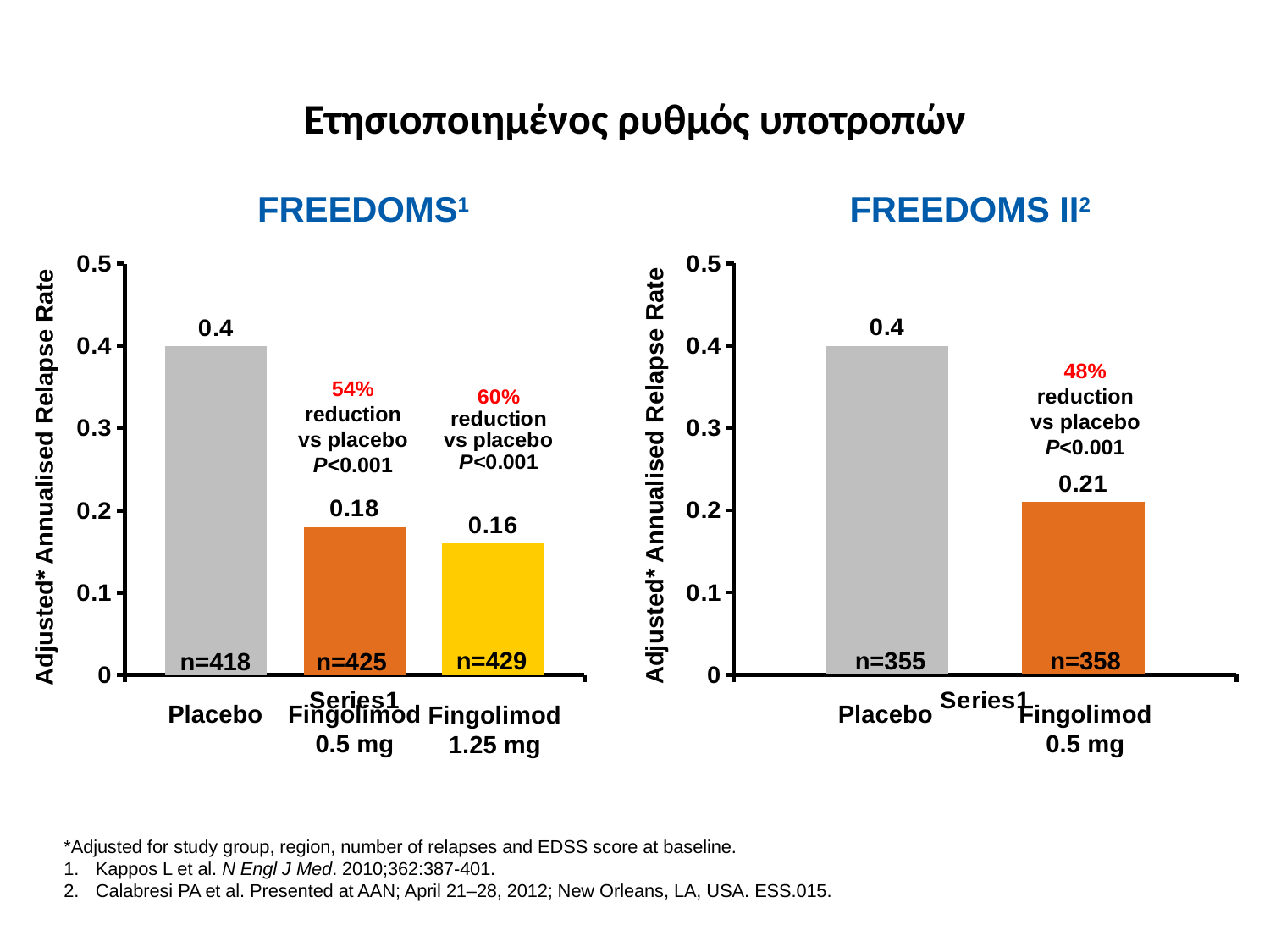
In the FREEDOMS chart, what is the adjusted annualised relapse rate for Fingolimod 0.5 mg? 0.18 In the FREEDOMS chart, what is the adjusted annualised relapse rate for Fingolimod 1.25 mg? 0.16 How many groups are shown in the FREEDOMS chart? 3 In the FREEDOMS chart, what is the adjusted annualised relapse rate for Placebo? 0.4 In the FREEDOMS II chart, what is the percentage reduction vs placebo shown for Fingolimod 0.5 mg? 48% In the FREEDOMS chart, what is the difference in adjusted annualised relapse rate between Placebo and Fingolimod 0.5 mg? 0.22 Which is larger: the Fingolimod 0.5 mg relapse rate in FREEDOMS or in FREEDOMS II? FREEDOMS II In the FREEDOMS II chart, what is the adjusted annualised relapse rate for Fingolimod 0.5 mg? 0.21 In the FREEDOMS II chart, which group has the highest adjusted annualised relapse rate? Placebo What type of chart is used for FREEDOMS II? Bar chart In the FREEDOMS II chart, what is the difference in adjusted annualised relapse rate between Placebo and Fingolimod 0.5 mg? 0.19 In the FREEDOMS chart, which group has the lowest adjusted annualised relapse rate? Fingolimod 1.25 mg